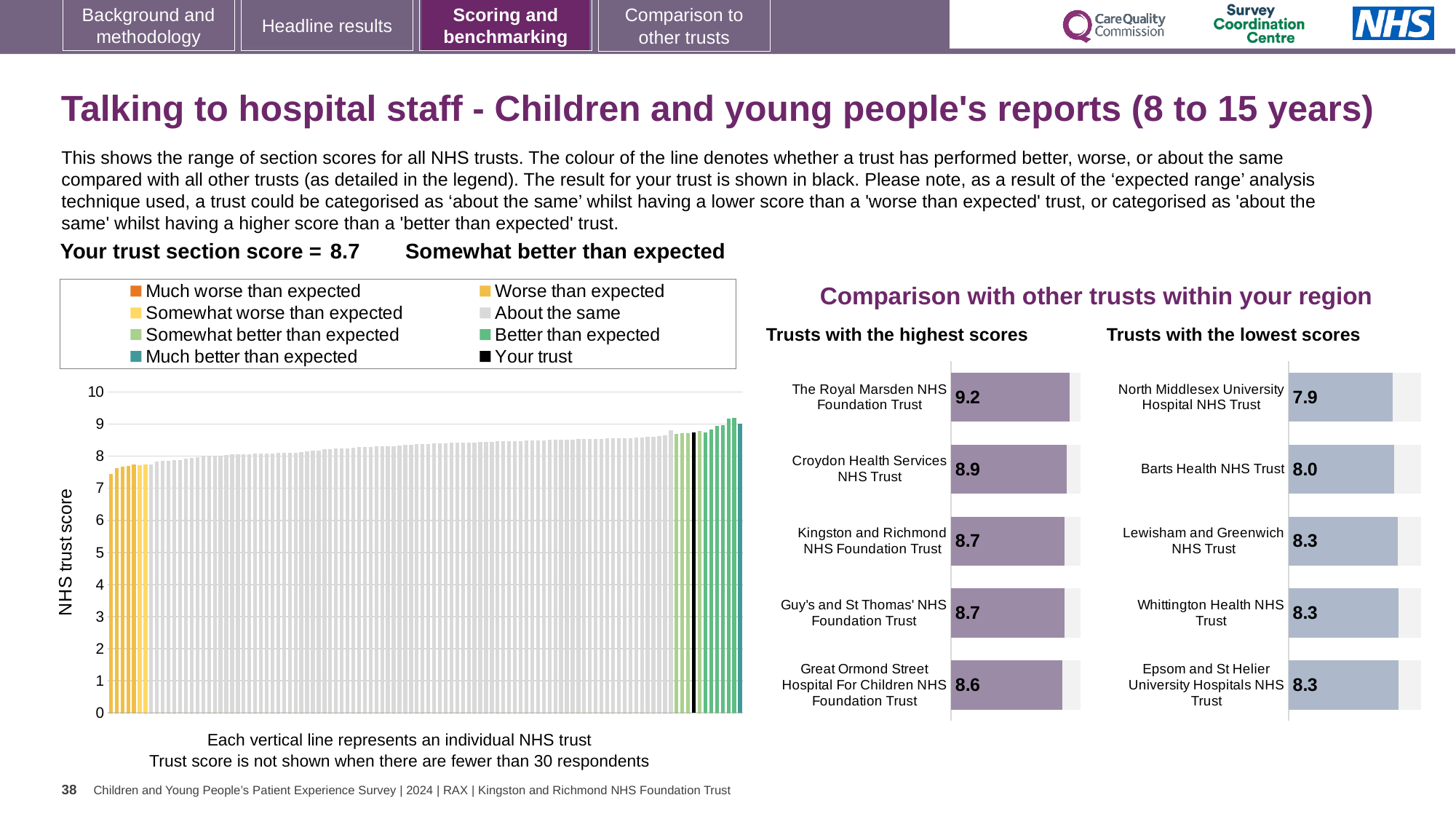
In the 'Trusts with the lowest scores' chart, what is the score for Barts Health NHS Trust? 8.0 How many trusts are shown in the 'Trusts with the highest scores' chart? 5 In the 'NHS trust score' chart on the left, do the bar values rise or fall from left to right? Rise In the 'Trusts with the lowest scores' chart, what is the score for Whittington Health NHS Trust? 8.3 In the 'NHS trust score' chart on the left, is the value of the black 'Your trust' bar greater or less than 8? greater In the 'Trusts with the highest scores' chart, what is the score for The Royal Marsden NHS Foundation Trust? 9.2 What kind of chart is the 'NHS trust score' chart on the left of the slide? Bar chart In the 'Trusts with the lowest scores' chart, which has the larger score: North Middlesex University Hospital NHS Trust or Lewisham and Greenwich NHS Trust? Lewisham and Greenwich NHS Trust In the 'Trusts with the lowest scores' chart, which trust has the lowest score? North Middlesex University Hospital NHS Trust In the 'Trusts with the highest scores' chart, which trust has the lowest score? Great Ormond Street Hospital For Children NHS Foundation Trust How many entries does the legend of the 'NHS trust score' chart on the left list? 8 In the 'Trusts with the highest scores' chart, what is the difference between the scores of The Royal Marsden NHS Foundation Trust and Croydon Health Services NHS Trust? 0.3